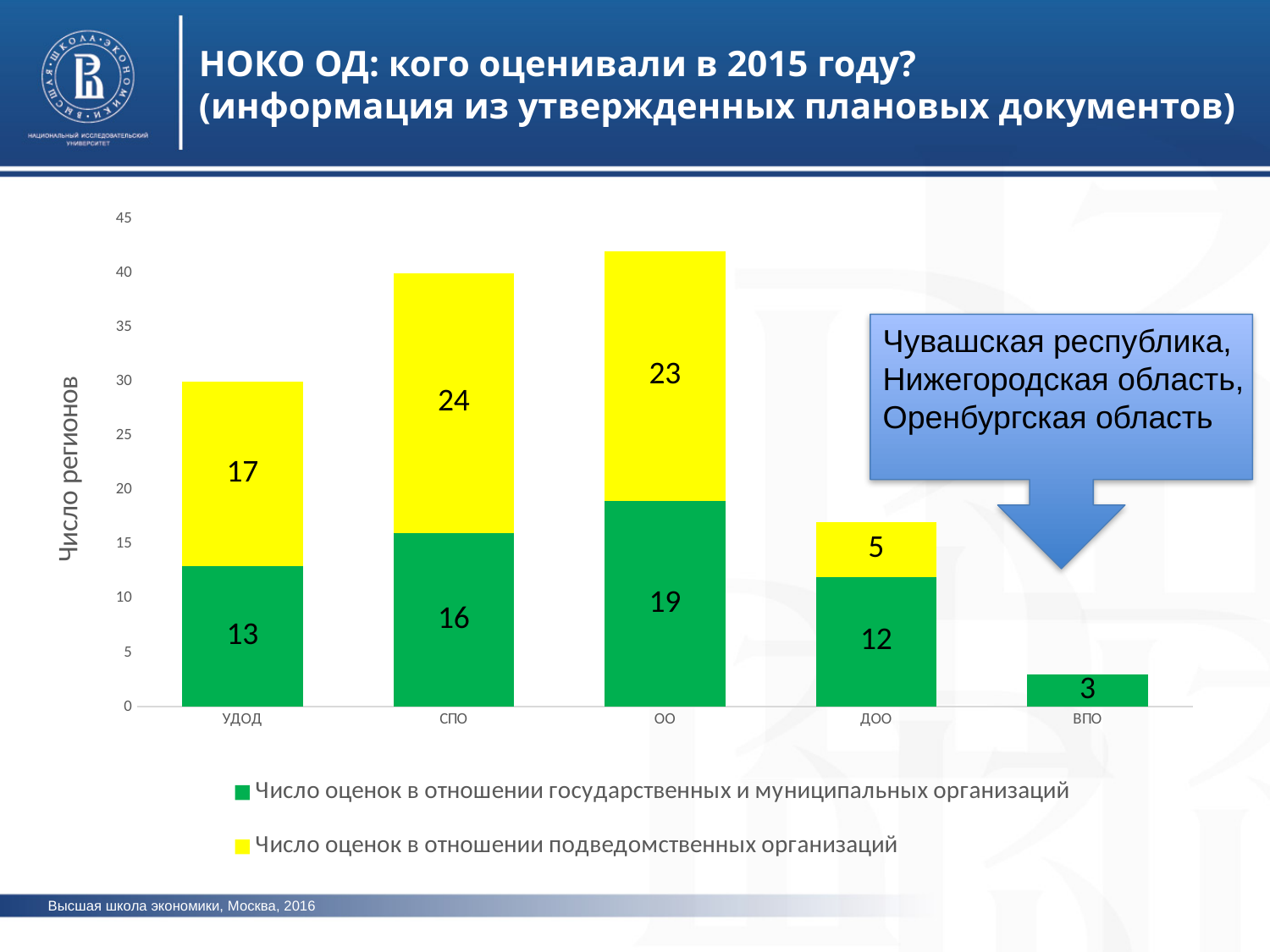
What is the value of 'Число оценок в отношении государственных и муниципальных организаций' for СПО? 16 What is the total of the stacked bar for УДОД? 30 Which category has the highest value for 'Число оценок в отношении подведомственных организаций'? СПО What kind of chart is shown on the slide? Stacked bar chart Which is larger: the 'Число оценок в отношении государственных и муниципальных организаций' value for ОО or for ДОО? ОО Which category has the lowest value for 'Число оценок в отношении государственных и муниципальных организаций'? ВПО What is the difference between the 'Число оценок в отношении подведомственных организаций' values for СПО and ДОО? 19 What is the value of 'Число оценок в отношении государственных и муниципальных организаций' for ВПО? 3 How many series does the chart legend list? 2 What is the value of 'Число оценок в отношении подведомственных организаций' for ОО? 23 What is the label of the y axis of the chart? Число регионов How many categories are shown on the x axis of the chart? 5